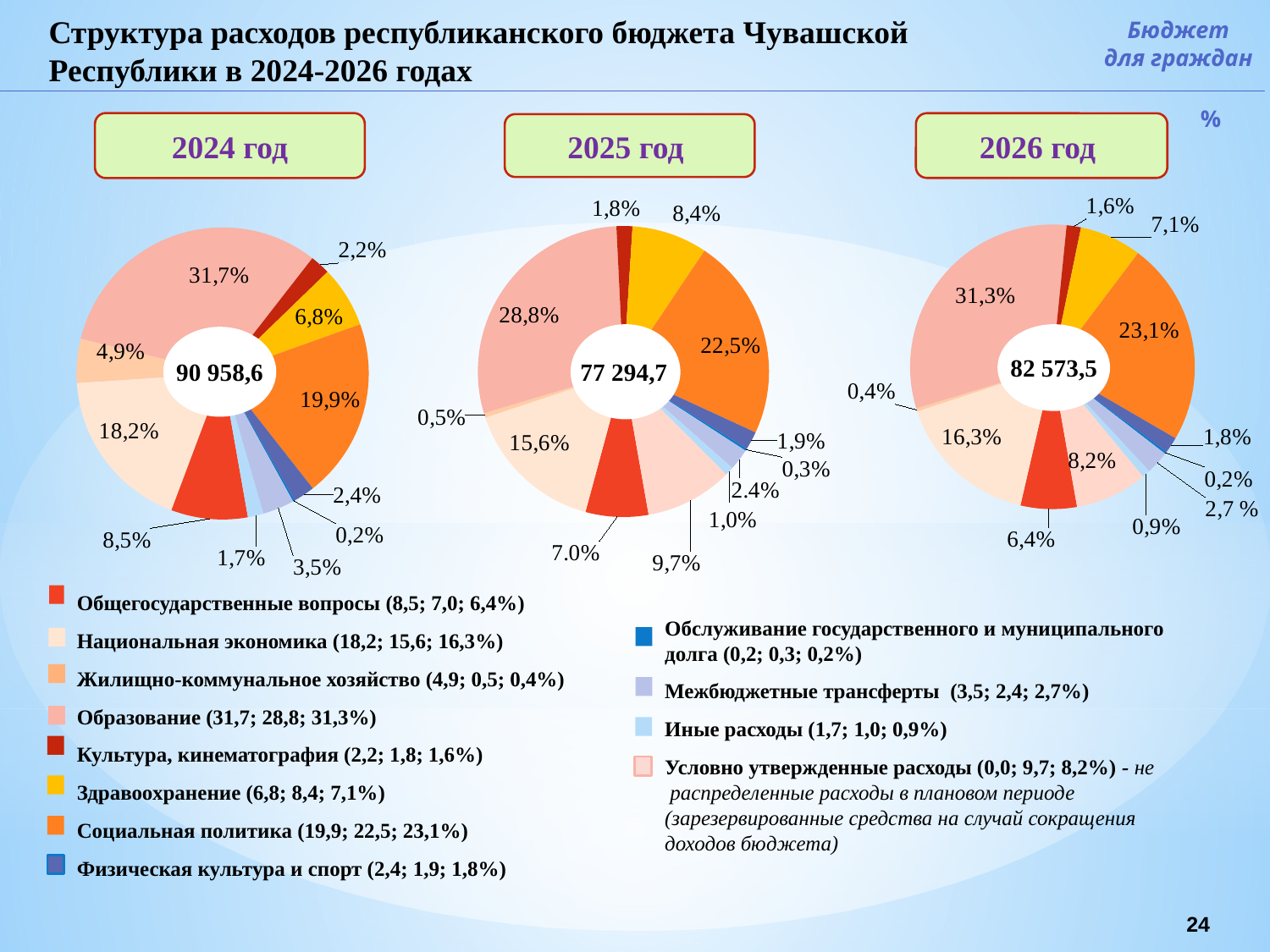
In the 2026 год chart, what is the difference between the shares of Образование and Социальная политика? 8,2% What total value is printed in the centre of the 2026 год chart? 82 573,5 How many categories does the legend list? 12 Does the share of Социальная политика rise or fall from 2024 to 2026? rises What total value is printed in the centre of the 2025 год chart? 77 294,7 In the 2025 год chart, what share is labelled for Социальная политика? 22,5% In the 2026 год chart, what share is labelled for Национальная экономика? 16,3% What kind of chart is used to show the 2024 budget expenditure structure? pie chart In the 2024 год chart, which category has the smallest share? Обслуживание государственного и муниципального долга In the 2024 год chart, which category has the largest share? Образование In the 2024 год chart, what share is labelled for Образование? 31,7% In the 2025 год chart, which is larger: Здравоохранение or Общегосударственные вопросы? Здравоохранение